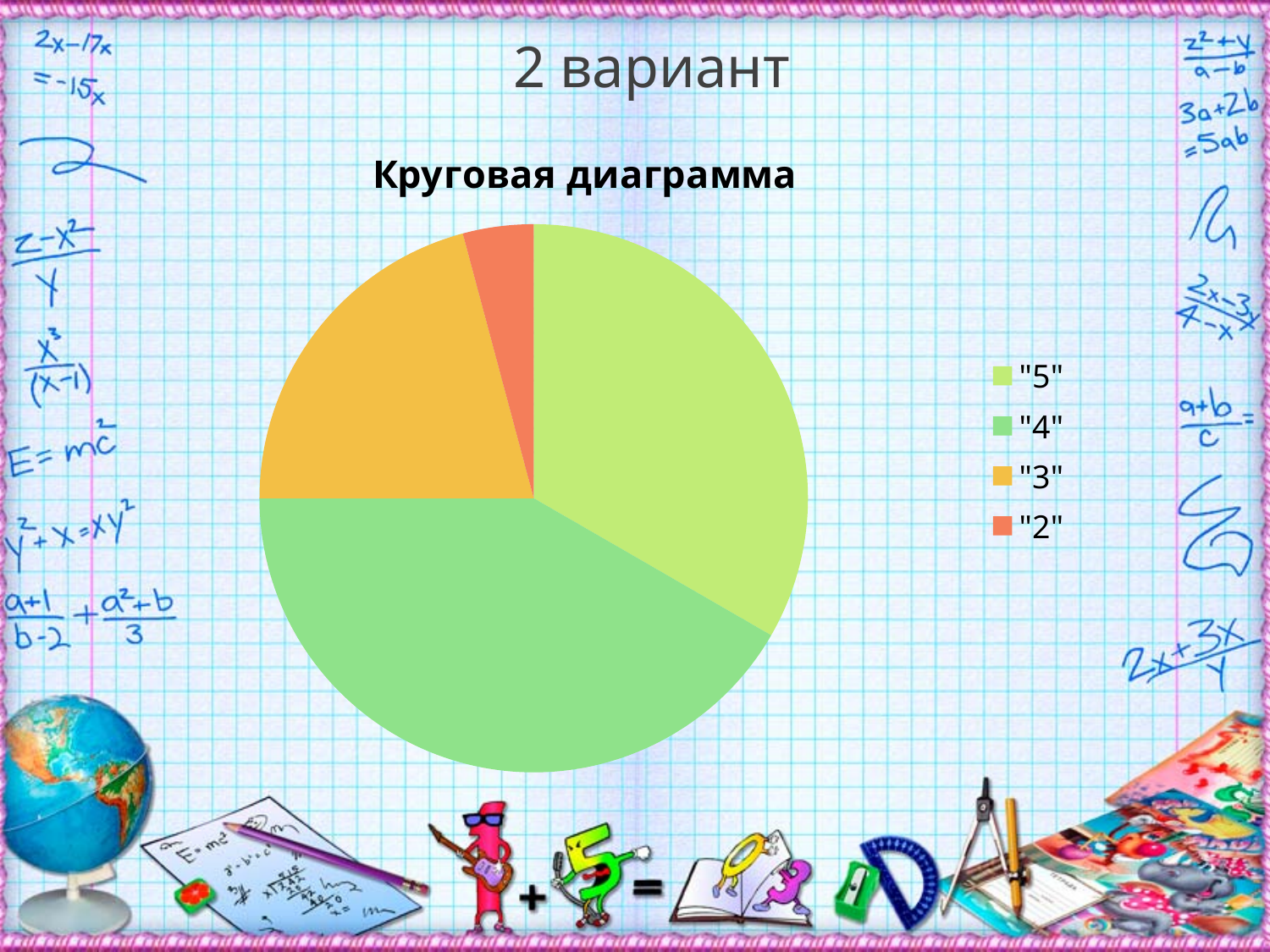
Which slice is larger, "4" or "5"? "4" What is the title of the chart? Круговая диаграмма Which slice is larger, "3" or "2"? "3" How many entries does the legend list? 4 Which category has the smallest slice of the pie? "2" What colour is the slice for "2" in the pie chart? red (coral) Which category has the largest slice of the pie? "4" What kind of chart is shown on the slide? pie chart How many slices does the pie chart have? 4 Which slice is larger, "5" or "3"? "5"